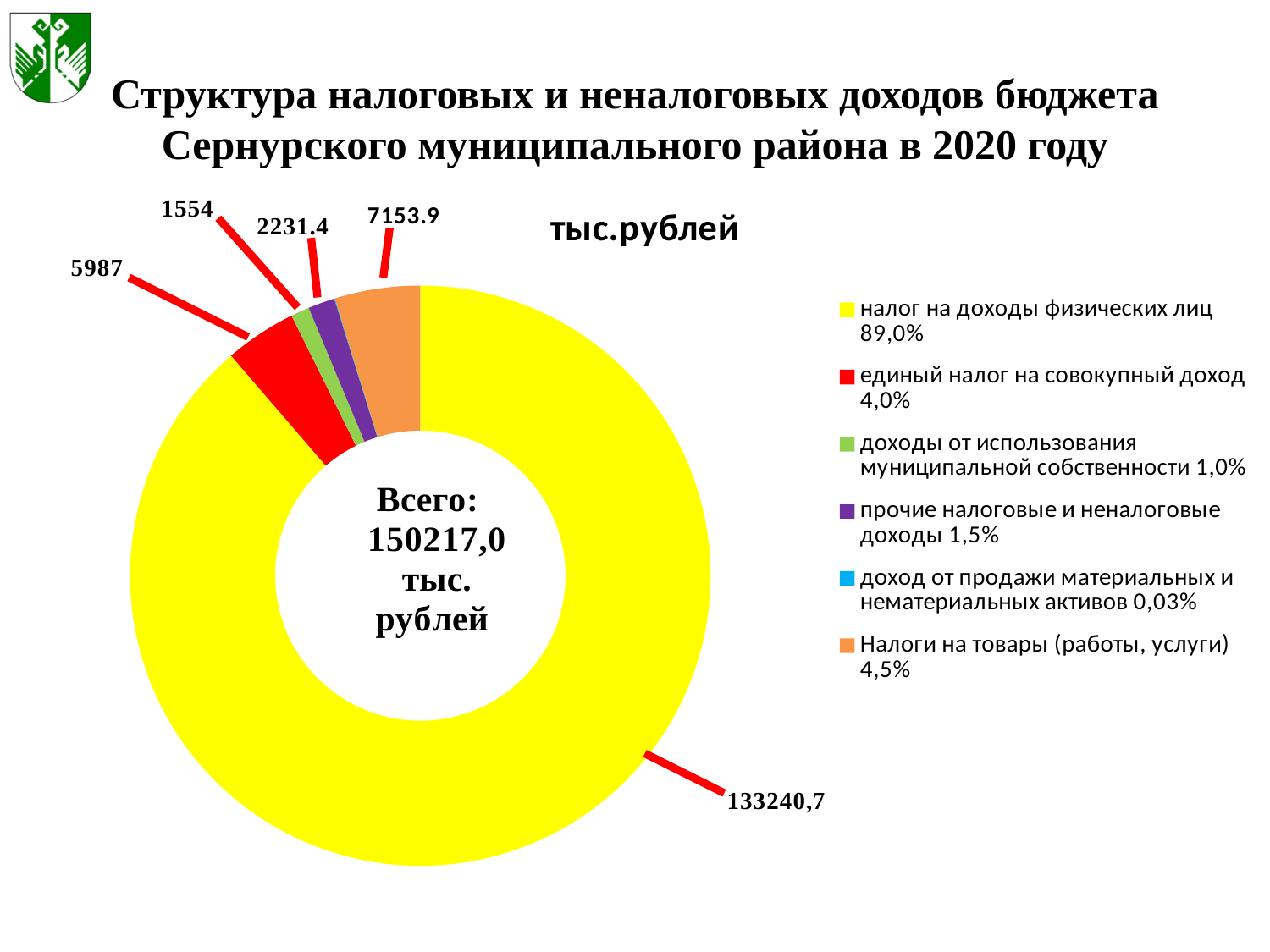
How many categories does the legend list? 6 Which category has the largest slice? налог на доходы физических лиц What is the difference between the values for Налоги на товары (работы, услуги) and единый налог на совокупный доход? 1166.9 Which is larger: прочие налоговые и неналоговые доходы or доходы от использования муниципальной собственности? прочие налоговые и неналоговые доходы Which category has the smallest share according to the legend? доход от продажи материальных и нематериальных активов What share of the total does Налоги на товары (работы, услуги) represent? 4,5% What is the value for доходы от использования муниципальной собственности? 1554 What share of the total does единый налог на совокупный доход represent? 4,0% What is the value for Налоги на товары (работы, услуги)? 7153.9 What is the value for прочие налоговые и неналоговые доходы? 2231.4 What is the value for единый налог на совокупный доход? 5987 What is the value for налог на доходы физических лиц? 133240,7